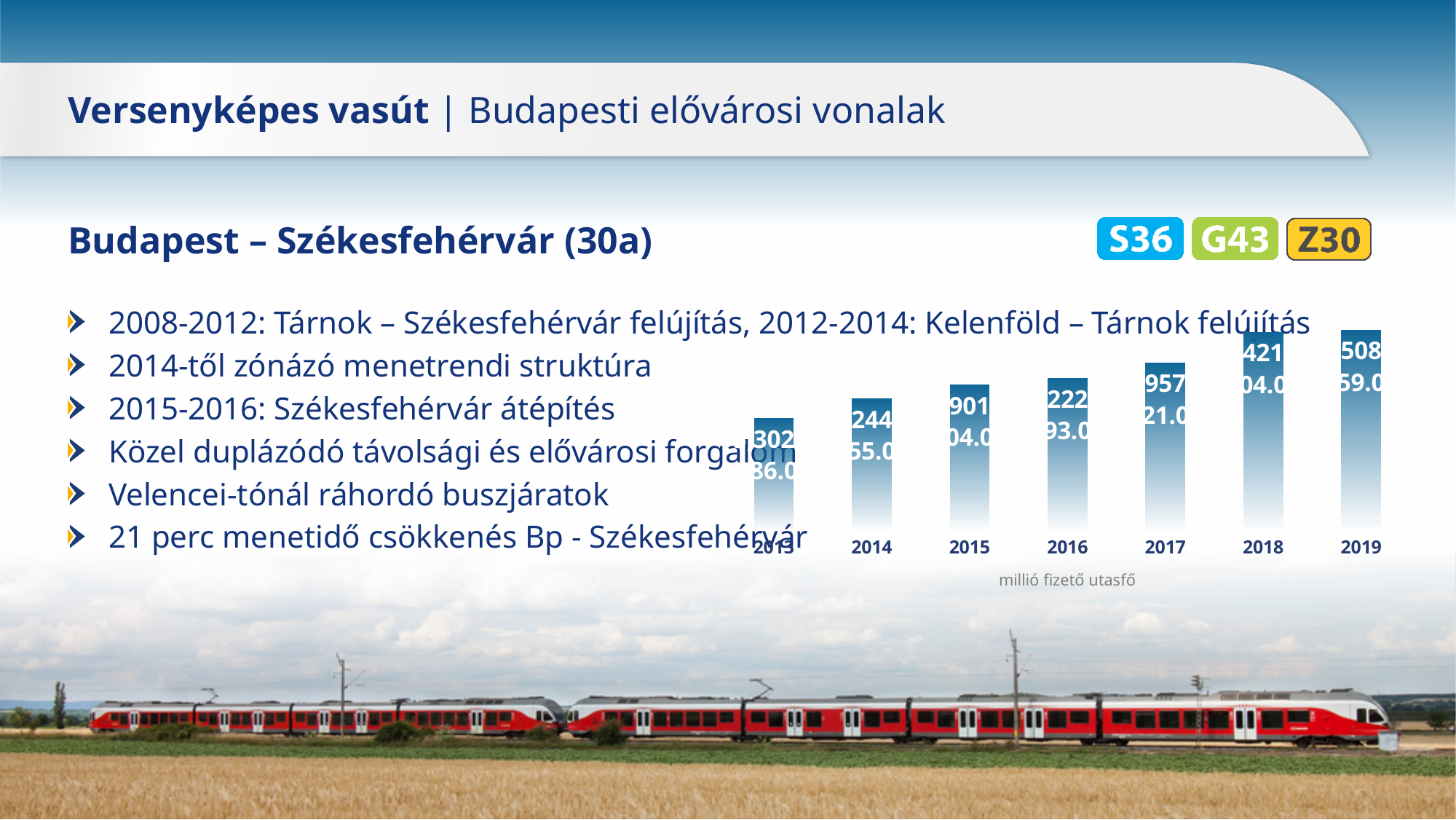
What kind of chart is shown on the slide? bar chart Do the bar values generally rise or fall from 2013 to 2019? rise Which bar is taller, 2016 or 2017? 2017 Which bar is taller, 2015 or 2018? 2018 Which year has the lowest bar in the chart? 2013 What unit label is printed below the chart's x axis? millió fizető utasfő Which bar is taller, 2014 or 2015? 2015 What is the first year shown on the x axis of the chart? 2013 How many years are shown on the x axis of the chart? 7